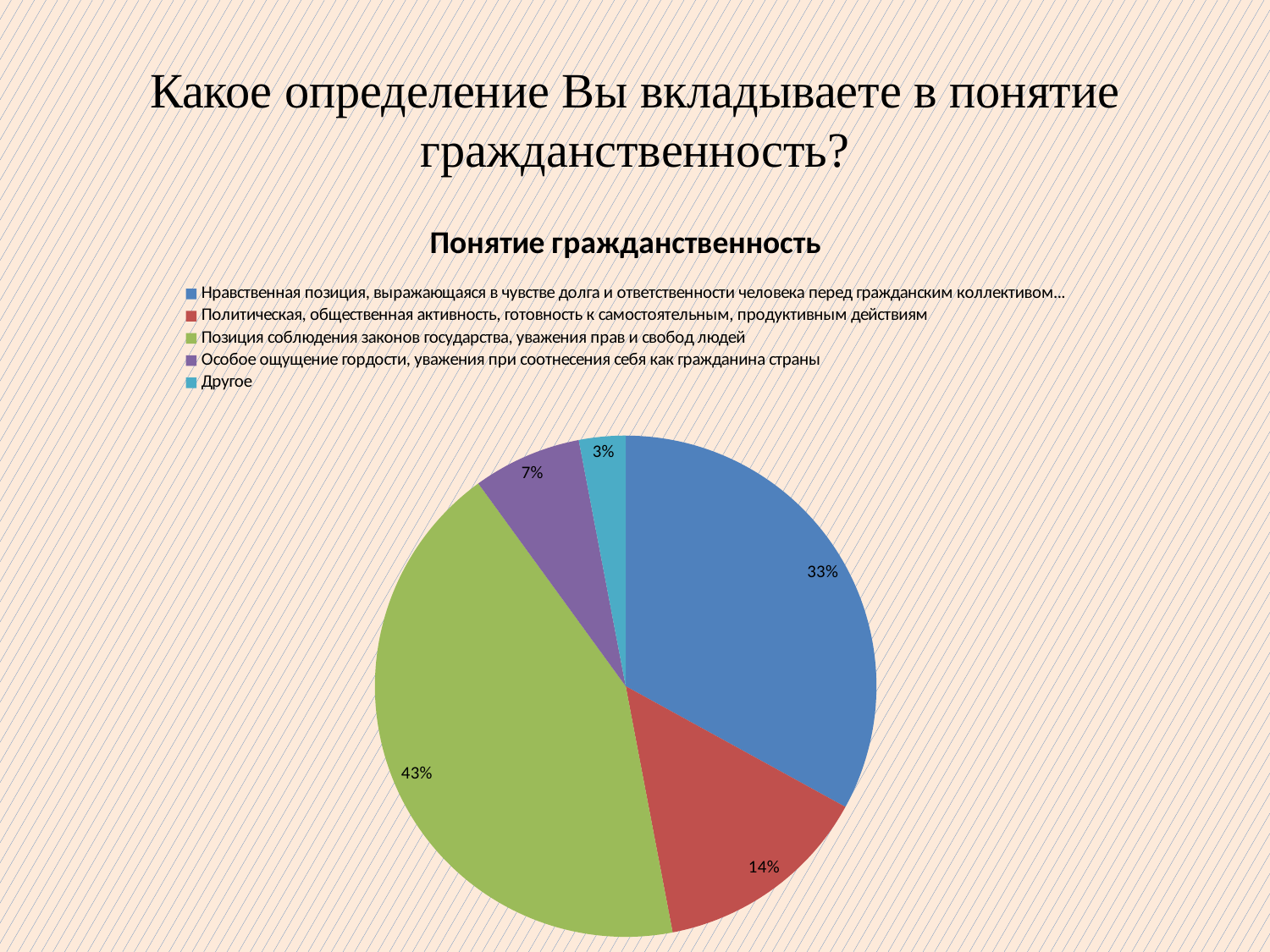
How many slices does the pie chart have? 5 What share of the pie is labelled "Политическая, общественная активность, готовность к самостоятельным, продуктивным действиям"? 14% What share of the pie is labelled "Другое"? 3% What share of the pie is labelled "Позиция соблюдения законов государства, уважения прав и свобод людей"? 43% What is the title of the chart? Понятие гражданственность Which category has the largest slice of the pie? Позиция соблюдения законов государства, уважения прав и свобод людей Which category has the smallest slice of the pie? Другое What colour is the slice labelled 43%? green Which is larger: the slice for "Особое ощущение гордости..." or the slice for "Политическая, общественная активность..."? Политическая, общественная активность, готовность к самостоятельным, продуктивным действиям What kind of chart is shown on the slide? pie chart What is the difference in percentage points between the largest slice (43%) and the blue slice (33%)? 10